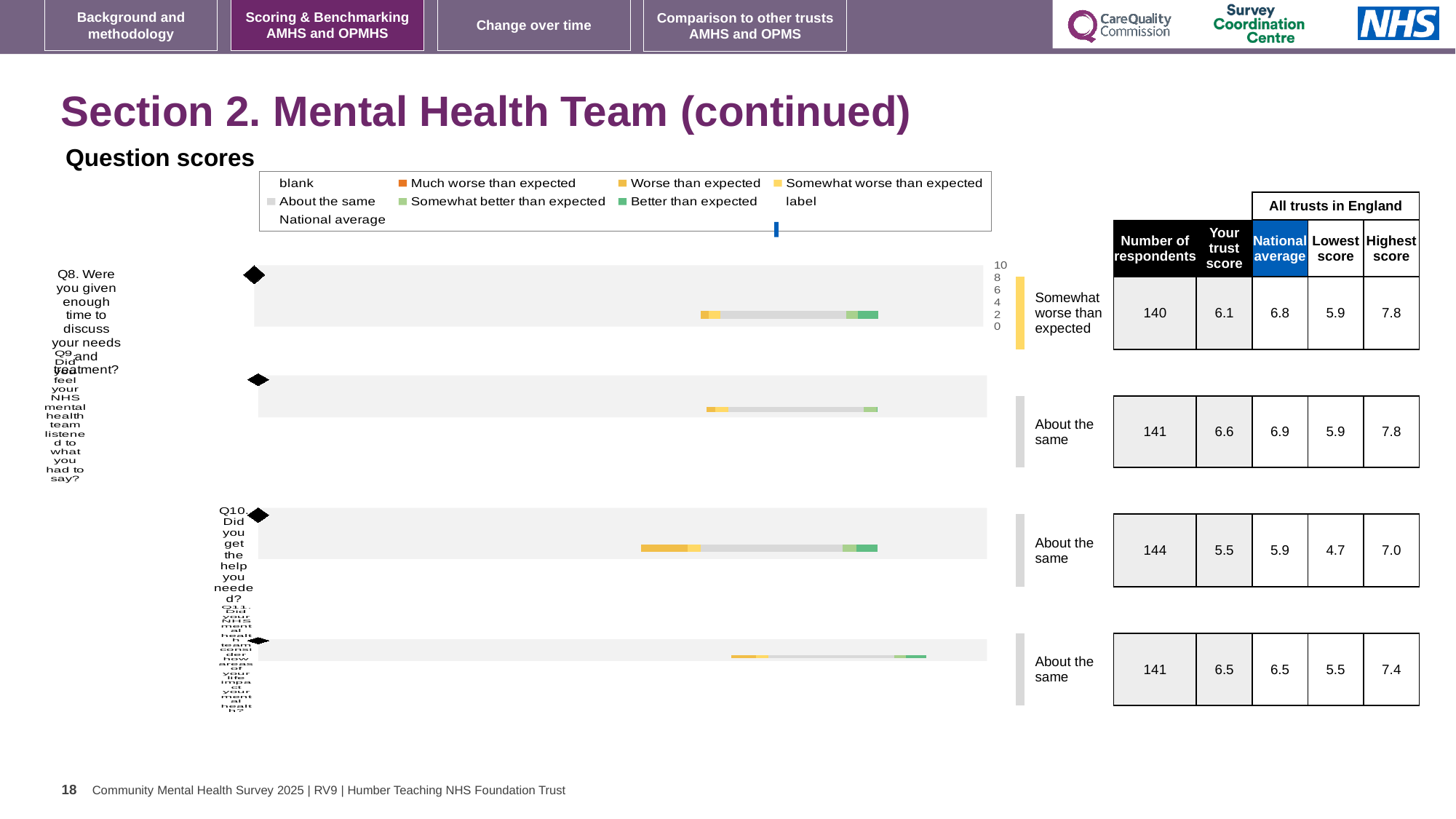
Which question has the highest number of respondents in the table beside the chart? Q10 For Q9, which is larger: the trust score or the national average? national average What is the heading printed above the chart? Question scores In the table beside the chart, what is the number of respondents for Q8 (Were you given enough time to discuss your needs and treatment?)? 140 In the table beside the chart, what is the national average for Q9 (Did you feel your NHS mental health team listened to what you had to say?)? 6.9 In the table beside the chart, what is the trust score for Q10 (Did you get the help you needed?)? 5.5 What kind of chart is used to show the question scores on this slide? bar chart What colour is the legend marker for 'Much worse than expected'? orange How many question bars (Q8 to Q11) are plotted in the question scores chart? 4 For Q8, what is the difference between the national average (6.8) and the trust score (6.1)? 0.7 Which question has the lowest trust score in the table beside the chart? Q10 What category label is shown next to the Q8 bar? Somewhat worse than expected